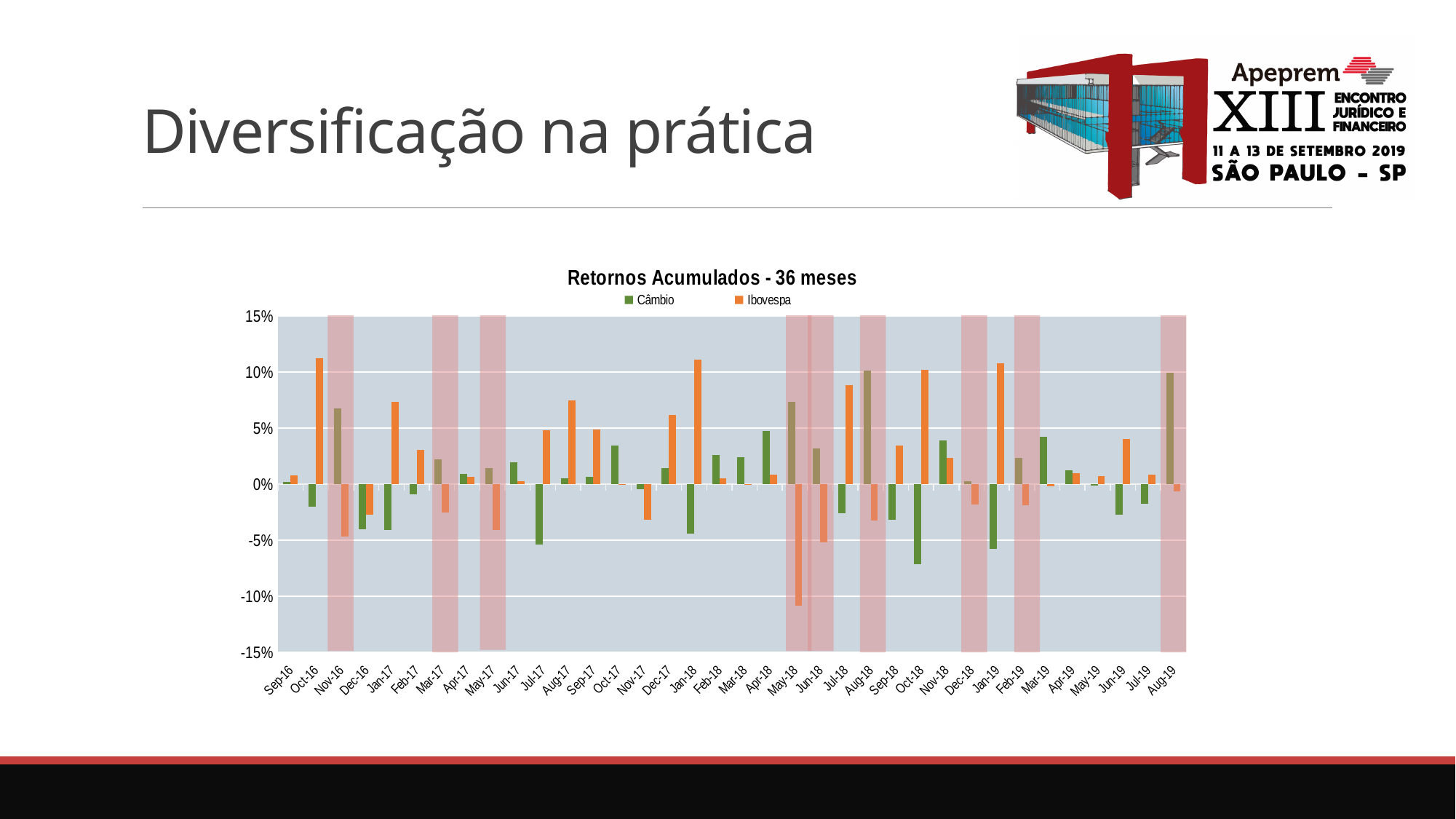
In which month does the Ibovespa series reach its lowest value? May-18 What kind of chart is shown on the slide? bar chart Is the Câmbio value for May-18 greater or less than 5%? greater In which month does the Câmbio series reach its lowest value? Oct-18 Is the Câmbio value for Oct-18 greater or less than -5%? less How many months are plotted along the x axis of the chart? 36 In Oct-16, which series has the larger value, Câmbio or Ibovespa? Ibovespa Is the Ibovespa value for Oct-16 greater or less than 10%? greater Which series is shown in orange in the chart? Ibovespa How many series does the chart's legend list? 2 What is the title of the chart? Retornos Acumulados - 36 meses